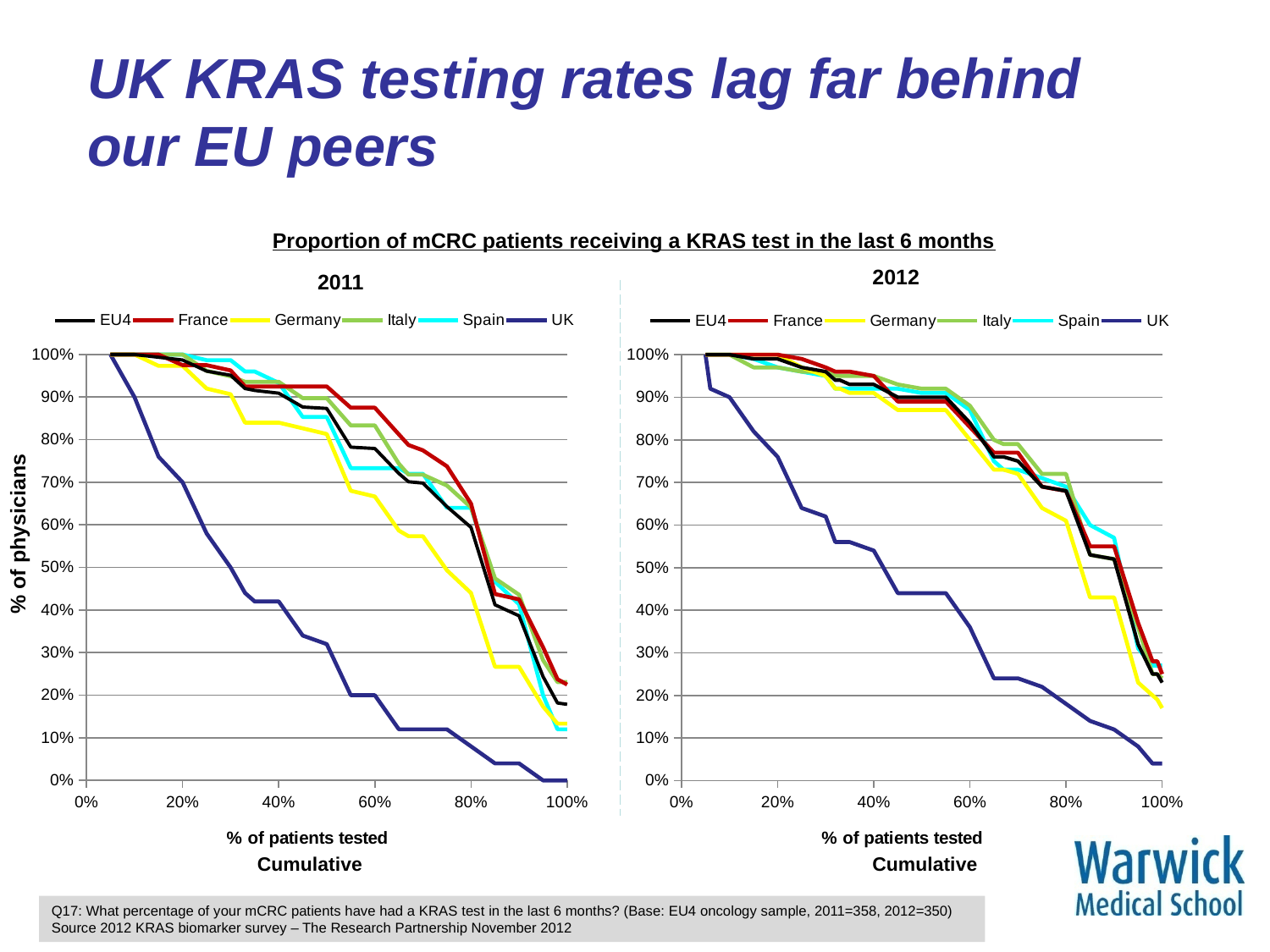
In the 2012 chart, is the value for UK at 80% of patients tested greater or less than 30%? less In the 2011 chart, do the values for UK rise or fall as % of patients tested increases? fall Which series are listed in the legend of the 2011 chart? EU4, France, Germany, Italy, Spain, UK What kind of chart is the 2011 chart? line chart In the 2011 chart, is the value for UK at 60% of patients tested greater or less than 30%? less How many series does the legend of the 2012 chart list? 6 What is the title shown above the two charts? Proportion of mCRC patients receiving a KRAS test in the last 6 months In the 2011 chart, is the value for Germany at 60% of patients tested greater or less than 60%? greater In the 2012 chart, at 80% of patients tested, which is larger: Germany or Italy? Italy In the 2012 chart, which series has the lowest value at 40% of patients tested? UK In the 2011 chart, at 40% of patients tested, which is larger: France or UK? France